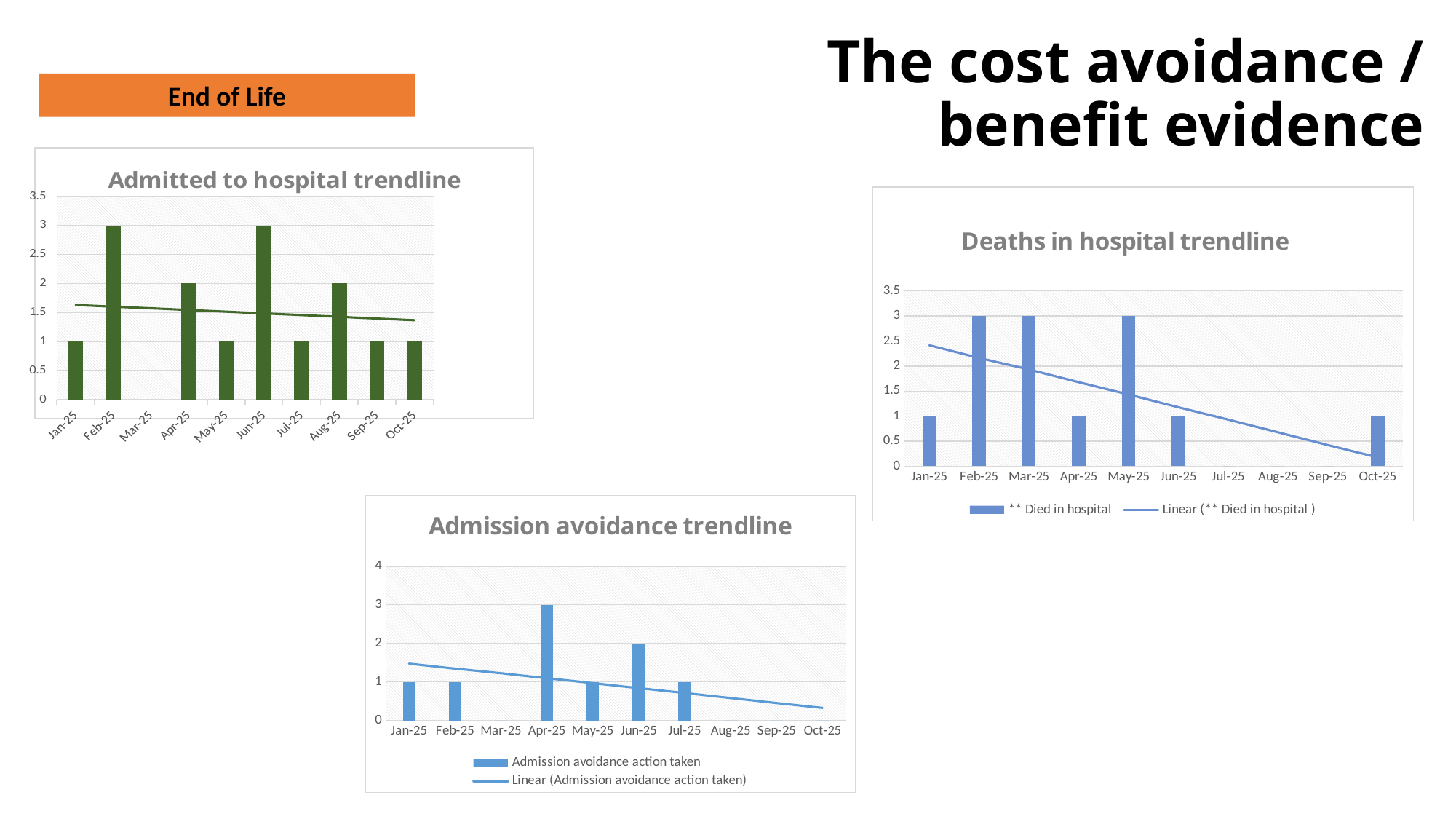
In the 'Admitted to hospital trendline' chart, is the value for Jun-25 greater or less than 2? greater In the 'Deaths in hospital trendline' chart, does the linear trendline rise or fall from Jan-25 to Oct-25? Fall How many months are shown on the x axis of the 'Deaths in hospital trendline' chart? 10 In the 'Admitted to hospital trendline' chart, what is the value for Feb-25? 3 What kind of chart is the 'Admitted to hospital trendline' chart? Bar chart with a linear trendline How many entries does the legend of the 'Admission avoidance trendline' chart list? 2 In the 'Admission avoidance trendline' chart, which month has the highest value? Apr-25 In the 'Admission avoidance trendline' chart, what is the difference between the values for Apr-25 and Jun-25? 1 In the 'Deaths in hospital trendline' chart, which is larger, the value for Feb-25 or the value for Jun-25? Feb-25 What is the title of the chart in the bottom centre of the slide? Admission avoidance trendline In the 'Deaths in hospital trendline' chart, what is the value for May-25? 3 In the 'Admitted to hospital trendline' chart, what is the value for Aug-25? 2